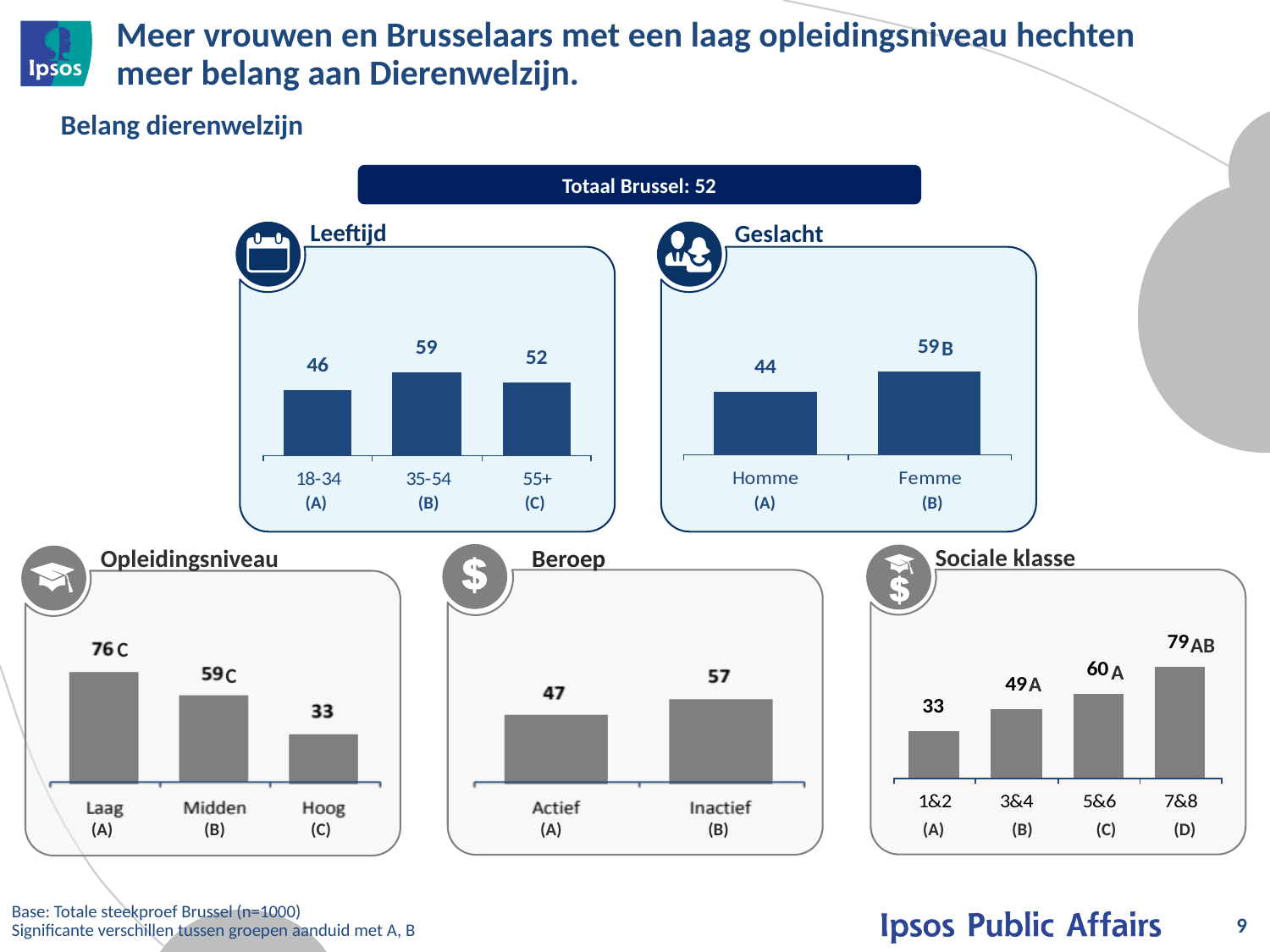
In the Opleidingsniveau chart, what is the value for Hoog? 33 In the Opleidingsniveau chart, which category has the highest value? Laag In the Leeftijd chart, which age group has the lowest value? 18-34 In the Geslacht chart, what is the value for Femme? 59 In the Geslacht chart, what is the difference between the values for Femme and Homme? 15 How many categories does the Sociale klasse chart show? 4 In the Beroep chart, which is larger, the value for Actief or Inactief? Inactief In the Leeftijd chart, what is the value for the 35-54 age group? 59 What type of chart is the Leeftijd chart? bar chart In the Beroep chart, what is the difference between the values for Inactief and Actief? 10 In the Sociale klasse chart, what is the value for 7&8? 79 In the Sociale klasse chart, do the values rise or fall from 1&2 to 7&8? rise